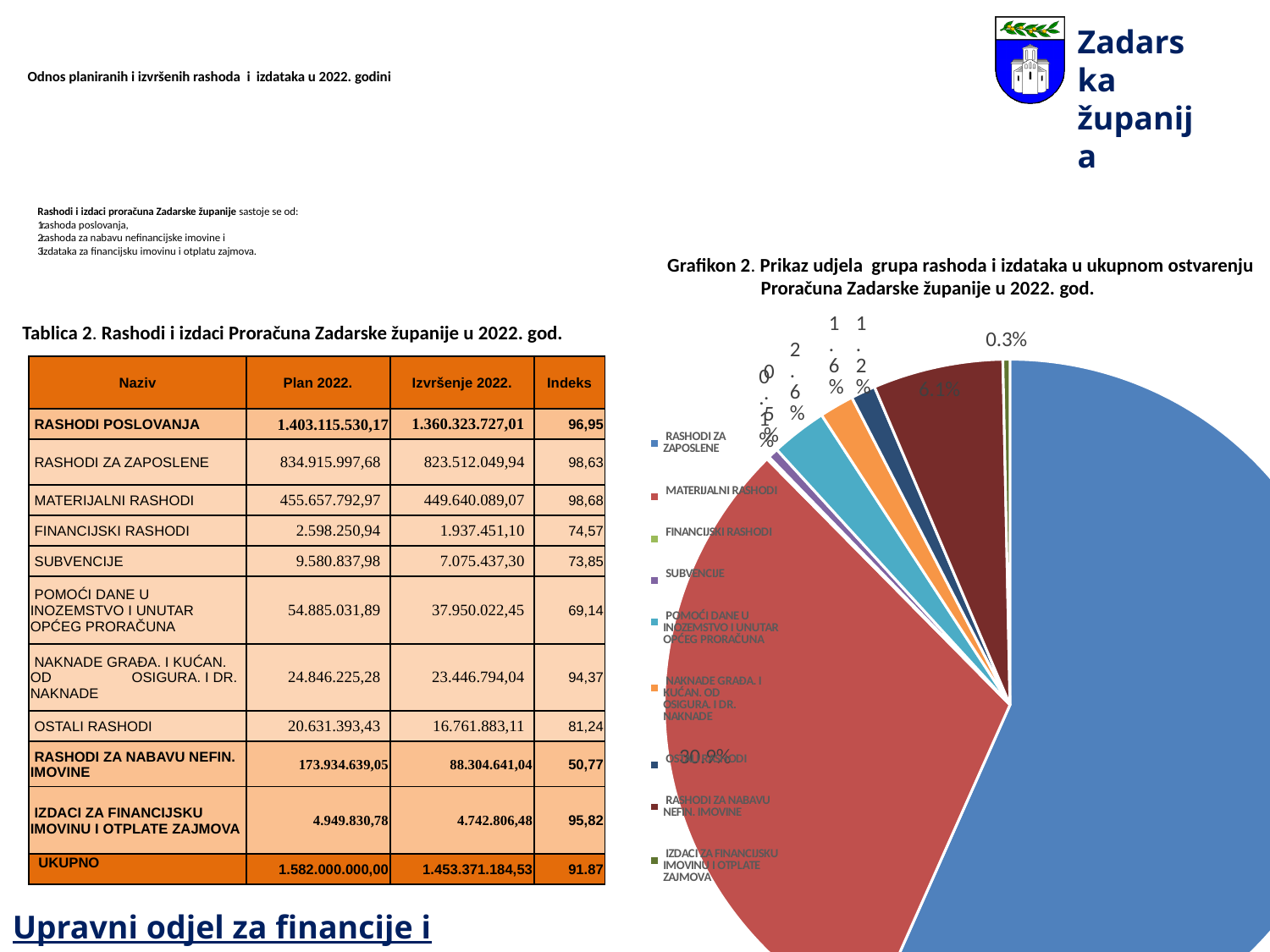
What share of the pie chart does RASHODI ZA NABAVU NEFIN. IMOVINE account for? 6.1% What kind of chart is Grafikon 2 on the slide? Pie chart What colour is the largest slice of the pie chart? Blue Which category has the largest slice in the pie chart? RASHODI ZA ZAPOSLENE What is the title of the pie chart on the slide? Grafikon 2. Prikaz udjela grupa rashoda i izdataka u ukupnom ostvarenju Proračuna Zadarske županije u 2022. god. What share of the pie chart does IZDACI ZA FINANCIJSKU IMOVINU I OTPLATE ZAJMOVA account for? 0.3% In the pie chart, what is the difference in percentage points between RASHODI ZA NABAVU NEFIN. IMOVINE (6.1%) and IZDACI ZA FINANCIJSKU IMOVINU I OTPLATE ZAJMOVA (0.3%)? 5.8 In the pie chart, what is the difference in percentage points between MATERIJALNI RASHODI (30.9%) and RASHODI ZA NABAVU NEFIN. IMOVINE (6.1%)? 24.8 How many categories does the legend of the pie chart list? 9 What share of the pie chart does MATERIJALNI RASHODI account for? 30.9% In the pie chart, which is larger: RASHODI ZA ZAPOSLENE or MATERIJALNI RASHODI? RASHODI ZA ZAPOSLENE In the pie chart, which is larger: MATERIJALNI RASHODI or RASHODI ZA NABAVU NEFIN. IMOVINE? MATERIJALNI RASHODI